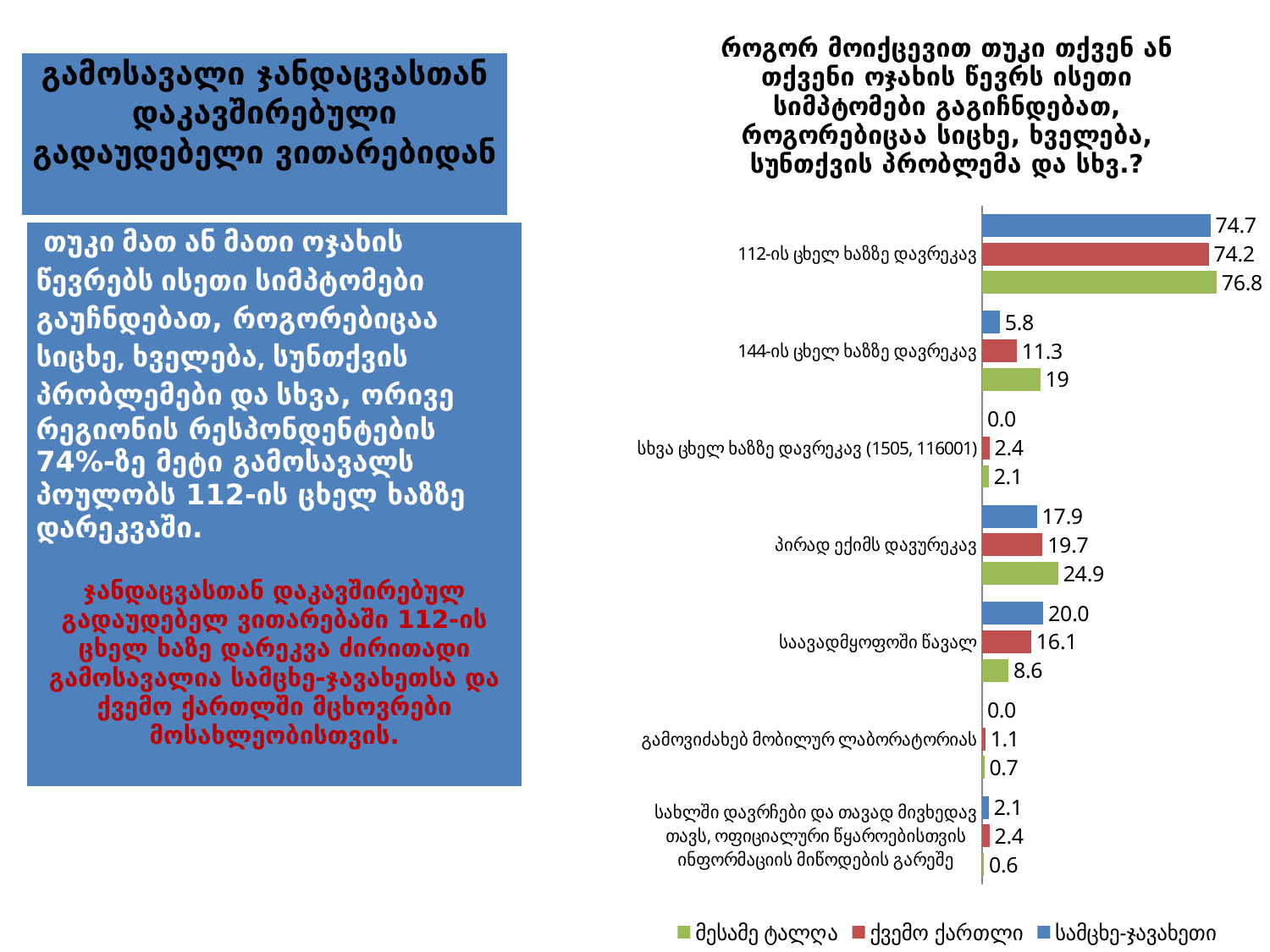
In the category 144-ის ცხელ ხაზზე დავრეკავ, which series has the larger value: ქვემო ქართლი or სამცხე-ჯავახეთი? ქვემო ქართლი Which category has the highest value for the მესამე ტალღა series? 112-ის ცხელ ხაზზე დავრეკავ What is the value for მესამე ტალღა in the category 144-ის ცხელ ხაზზე დავრეკავ? 19 What is the value for სამცხე-ჯავახეთი in the category გამოვიძახებ მობილურ ლაბორატორიას? 0.0 What is the value for ქვემო ქართლი in the category პირად ექიმს დავურეკავ? 19.7 How many series does the chart legend list? 3 What type of chart is shown on the slide? bar chart What is the difference between the სამცხე-ჯავახეთი and მესამე ტალღა values in the category საავადმყოფოში წავალ? 11.4 How many categories are shown on the chart? 7 What is the value for სამცხე-ჯავახეთი in the category 112-ის ცხელ ხაზზე დავრეკავ? 74.7 What is the difference between the მესამე ტალღა and ქვემო ქართლი values in the category 112-ის ცხელ ხაზზე დავრეკავ? 2.6 Which series is shown in green in the chart legend? მესამე ტალღა